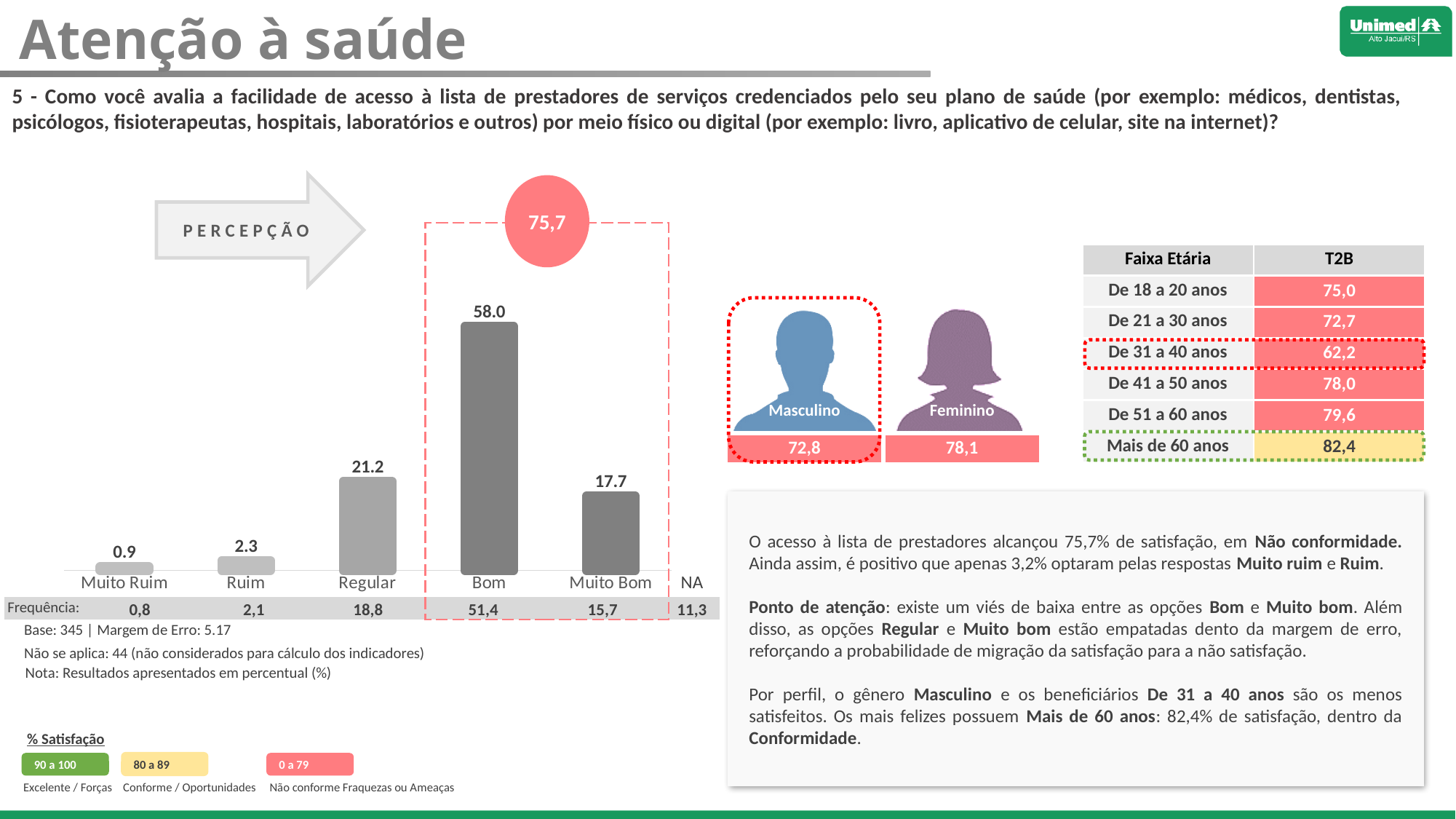
How many bars are plotted in the bar chart? 5 Which is larger, the value for Regular or the value for Muito Bom? Regular What is the difference between the values for Bom and Muito Bom? 40.3 What is the value for the Muito Bom category in the bar chart? 17.7 What value is shown in the pink circle above the dashed box around Bom and Muito Bom? 75,7 What is the value for the Bom category in the bar chart? 58.0 What is the value for the Muito Ruim category in the bar chart? 0.9 What is the value for the Regular category in the bar chart? 21.2 Which category has the highest value in the bar chart? Bom What is the difference between the values for Ruim and Muito Ruim? 1.4 Which category has the lowest value among the plotted bars? Muito Ruim What type of chart is shown on the slide? bar chart